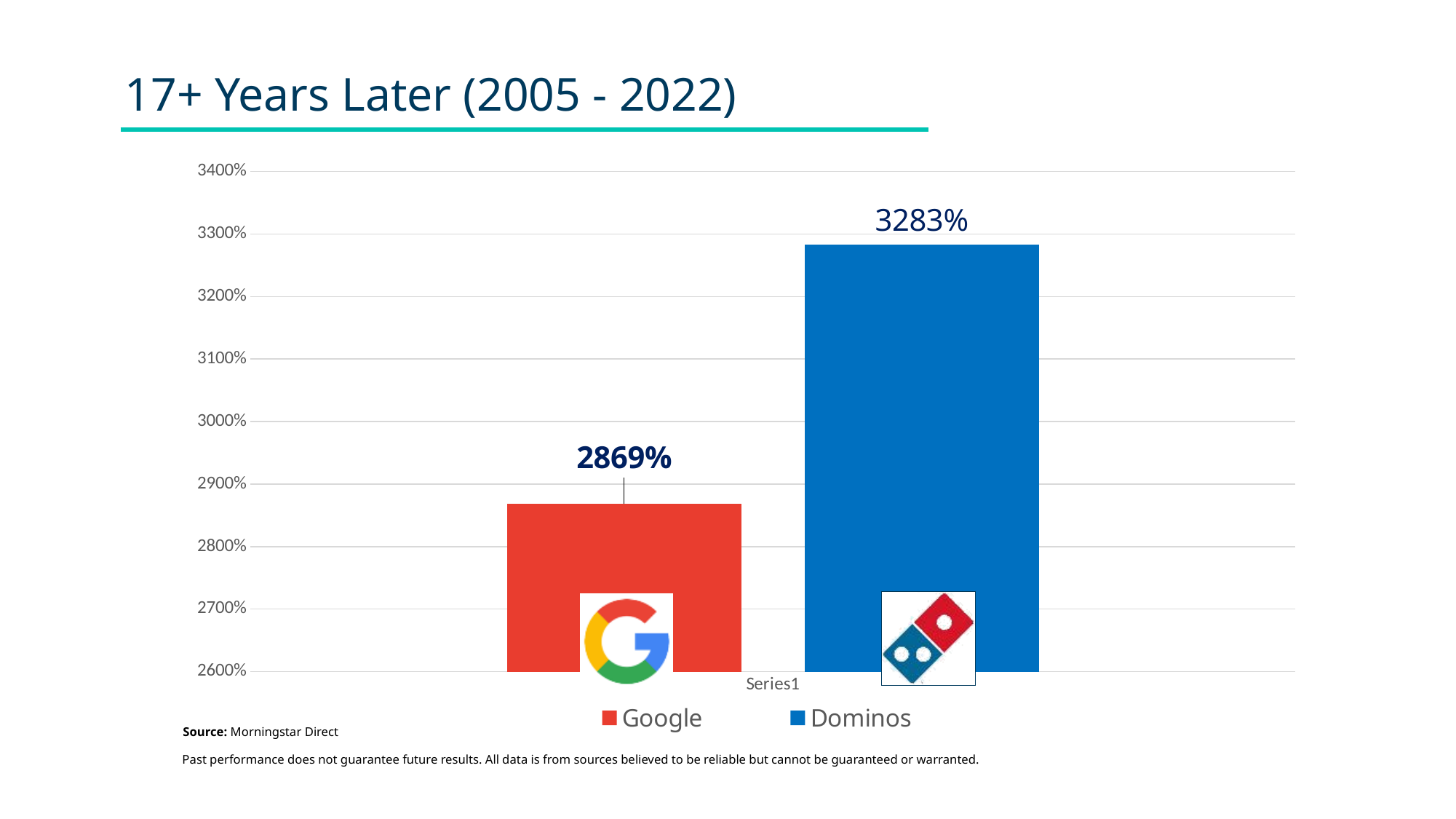
What is the difference between the Dominos value and the Google value? 414% What is the title of the slide? 17+ Years Later (2005 - 2022) What is the value shown for Google? 2869% Which series has the higher value, Google or Dominos? Dominos Is the value for Dominos greater or less than 3200%? greater Is the value for Google greater or less than 2900%? less What is the highest value shown on the vertical axis? 3400% What kind of chart is shown on the slide? bar chart What is the value shown for Dominos? 3283% How many series does the legend list? 2 What colour is the bar for Dominos? blue Which series has the lower value? Google